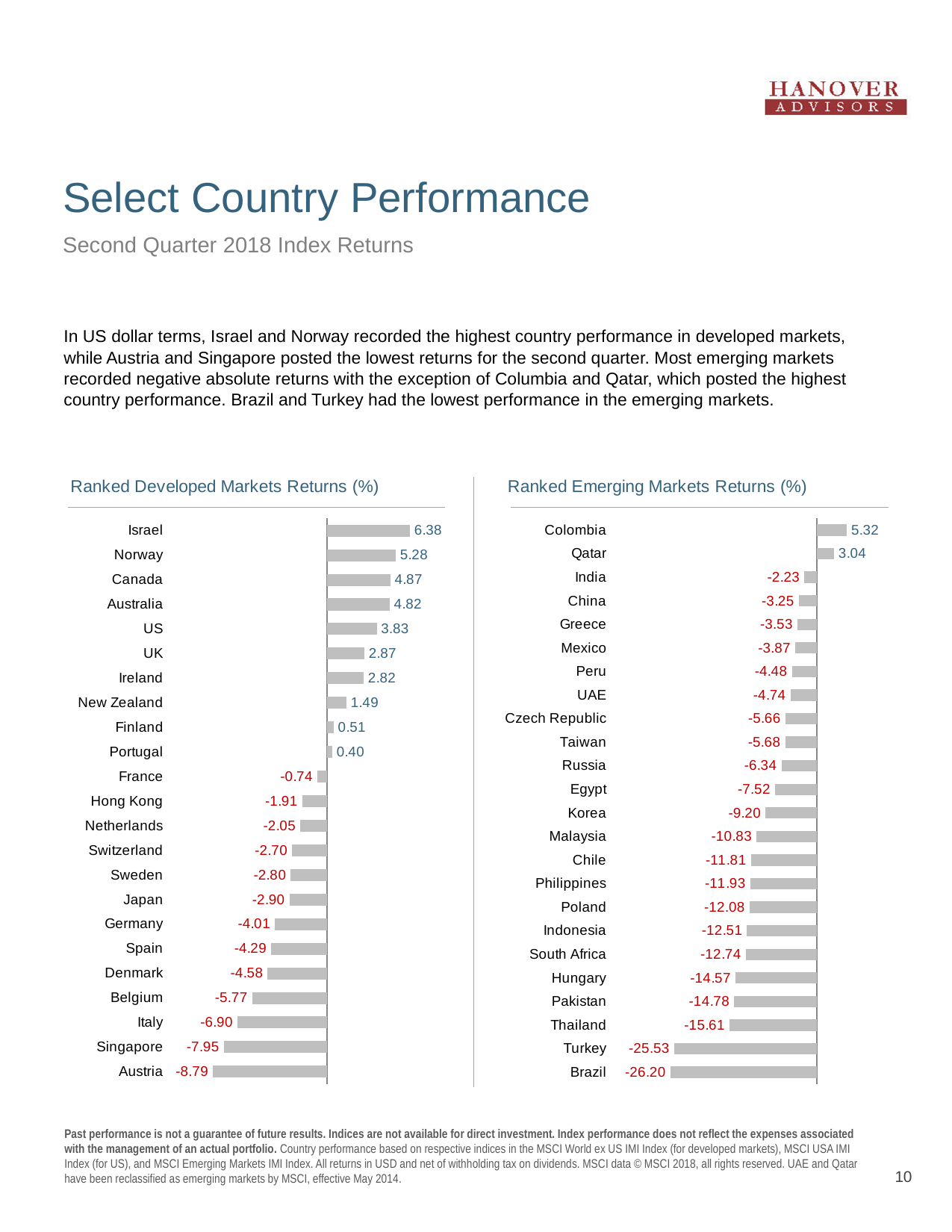
In the Ranked Developed Markets Returns (%) chart, what is the difference between the values for Israel and Austria? 15.17 In the Ranked Emerging Markets Returns (%) chart, which is larger, the value for India or the value for Korea? India What is the title of the chart on the left side of the slide? Ranked Developed Markets Returns (%) In the Ranked Emerging Markets Returns (%) chart, which country has the lowest return? Brazil In the Ranked Developed Markets Returns (%) chart, which is larger, the value for UK or the value for New Zealand? UK In the Ranked Developed Markets Returns (%) chart, which country has the highest return? Israel How many countries are shown in the Ranked Developed Markets Returns (%) chart? 23 What kind of chart is the Ranked Emerging Markets Returns (%) chart? Bar chart In the Ranked Developed Markets Returns (%) chart, what is the value for Canada? 4.87 In the Ranked Emerging Markets Returns (%) chart, what is the value for Russia? -6.34 In the Ranked Emerging Markets Returns (%) chart, what is the difference between the values for Colombia and Qatar? 2.28 How many countries are shown in the Ranked Emerging Markets Returns (%) chart? 24